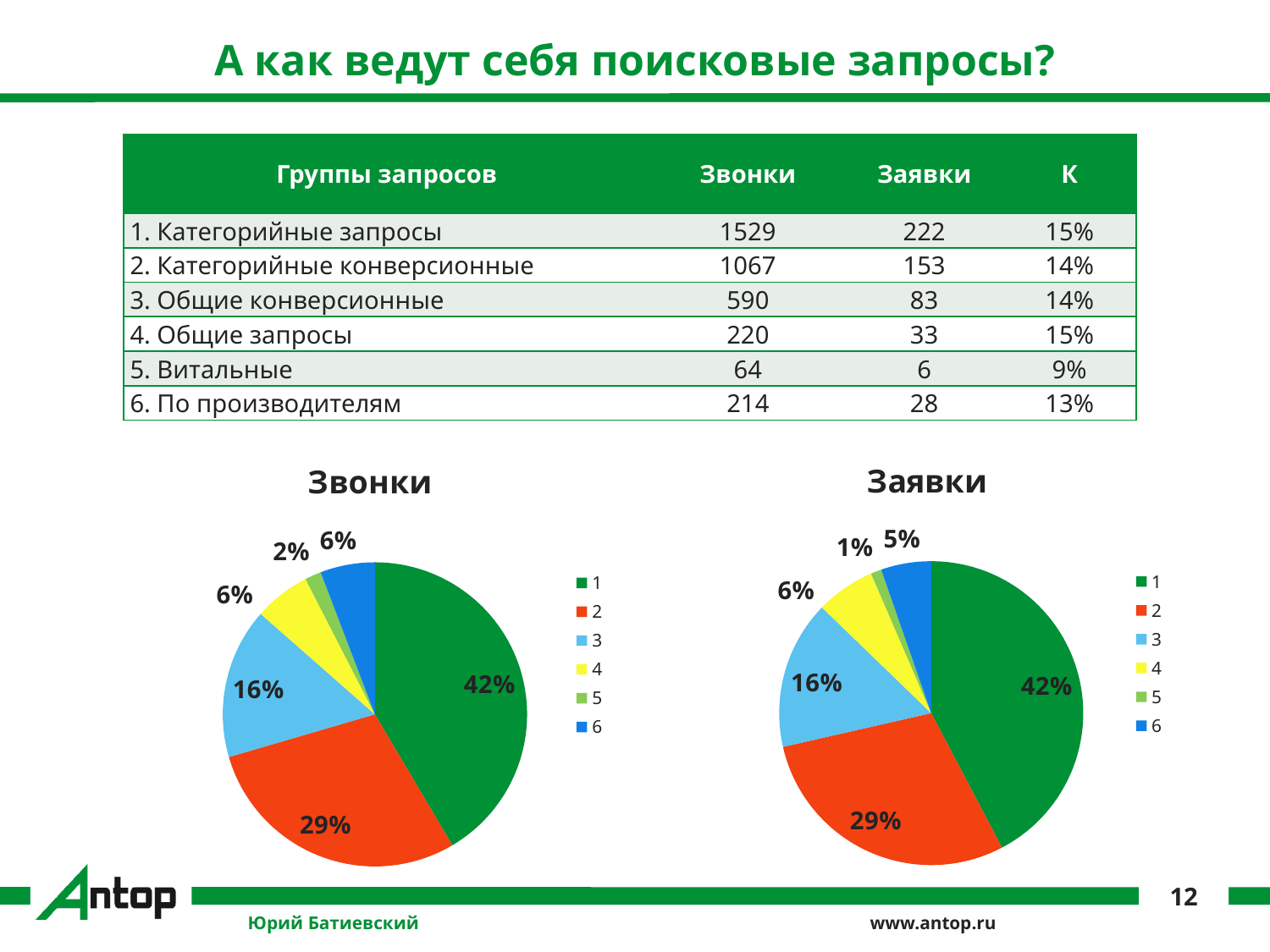
In the "Заявки" pie chart, which is larger, slice 3 or slice 4? 3 How many slices does the "Звонки" pie chart have? 6 In the "Звонки" pie chart, which slice is the largest? 1 In the "Звонки" pie chart, what share does slice 1 have? 42% In the "Заявки" pie chart, what share does slice 6 have? 5% In the "Звонки" pie chart, which slice is the smallest? 5 In the "Заявки" pie chart, which slice is the smallest? 5 In the "Звонки" pie chart, what share does slice 3 have? 16% In the "Звонки" pie chart, what is the difference between the shares of slice 1 and slice 2? 13% What type of chart is the "Заявки" chart? pie chart